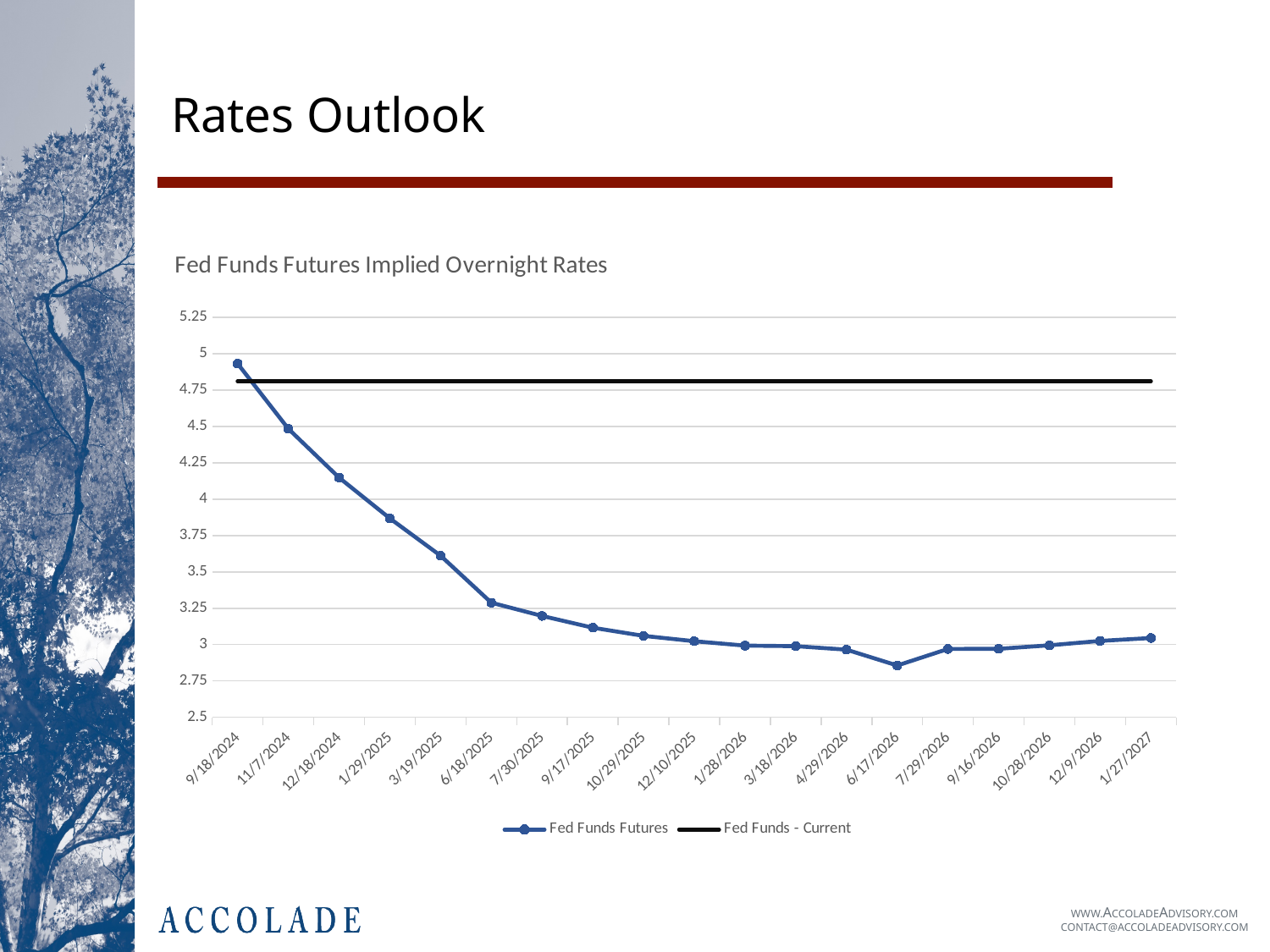
How many series does the legend list? 2 What type of chart is shown on the slide? Line chart Is the Fed Funds Futures value for 6/17/2026 greater or less than 3? less What is the title of the chart? Fed Funds Futures Implied Overnight Rates On which date is the Fed Funds Futures value highest? 9/18/2024 What are the two series named in the legend? Fed Funds Futures and Fed Funds - Current Which is larger, the Fed Funds Futures value for 9/18/2024 or for 1/27/2027? 9/18/2024 Is the Fed Funds Futures value for 9/18/2024 greater or less than 4.75? greater Does the Fed Funds Futures line generally rise or fall from 9/18/2024 to 1/28/2026? fall Is the Fed Funds Futures value for 11/7/2024 greater or less than 4.25? greater On which date is the Fed Funds Futures value lowest? 6/17/2026 How many dates are plotted along the x axis? 19